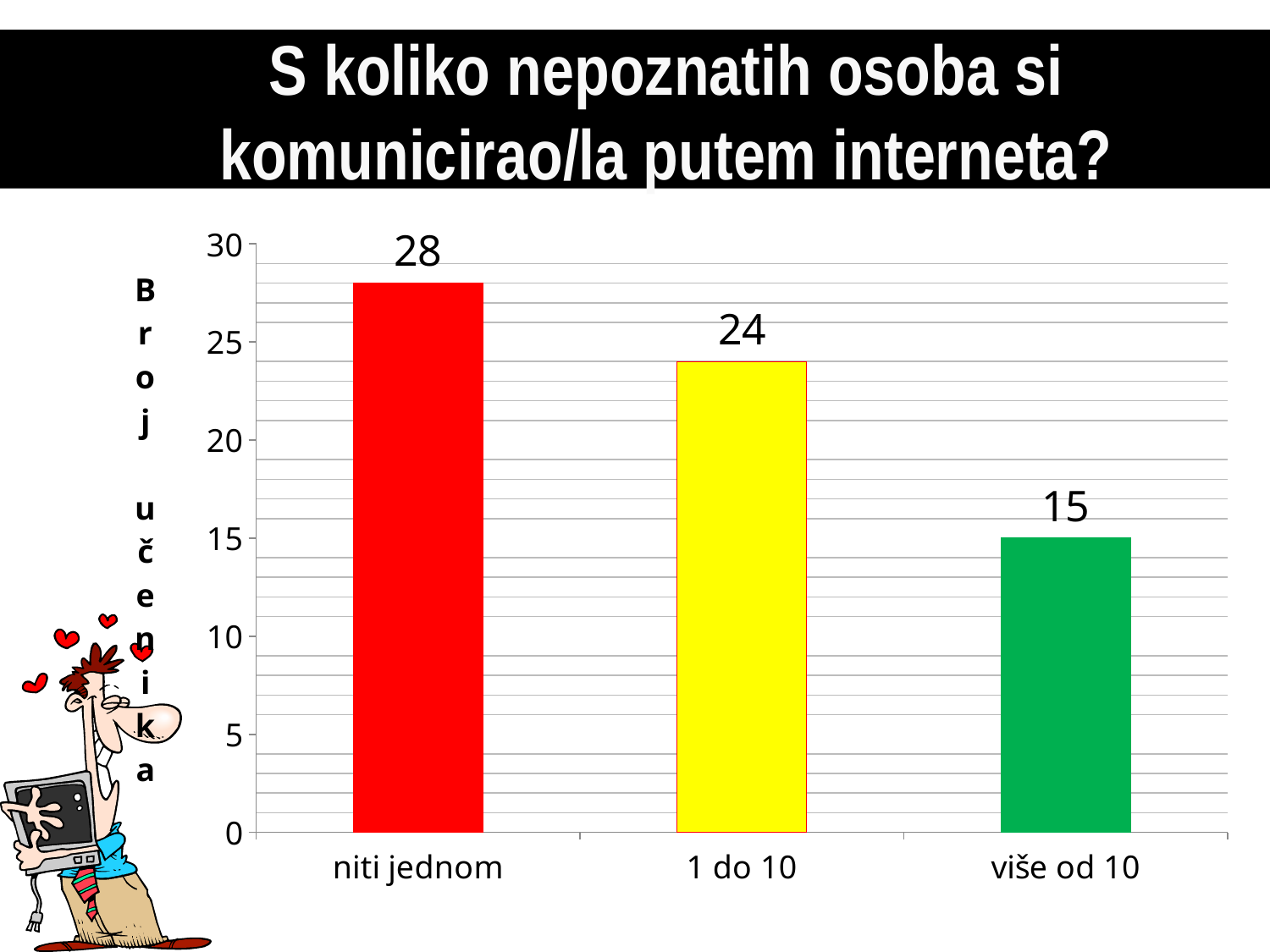
Is the value for "1 do 10" greater or less than 20? greater What is the value for "niti jednom"? 28 Which category has the lowest value? više od 10 What is the difference between the values for "niti jednom" and "1 do 10"? 4 How many categories are shown on the x axis? 3 What is the value for "više od 10"? 15 Which category has the highest value? niti jednom What kind of chart is shown on the slide? bar chart Do the values rise or fall from left to right along the x axis? fall What is the difference between the values for "niti jednom" and "više od 10"? 13 What is the value for "1 do 10"? 24 Which is larger, the value for "1 do 10" or the value for "više od 10"? 1 do 10